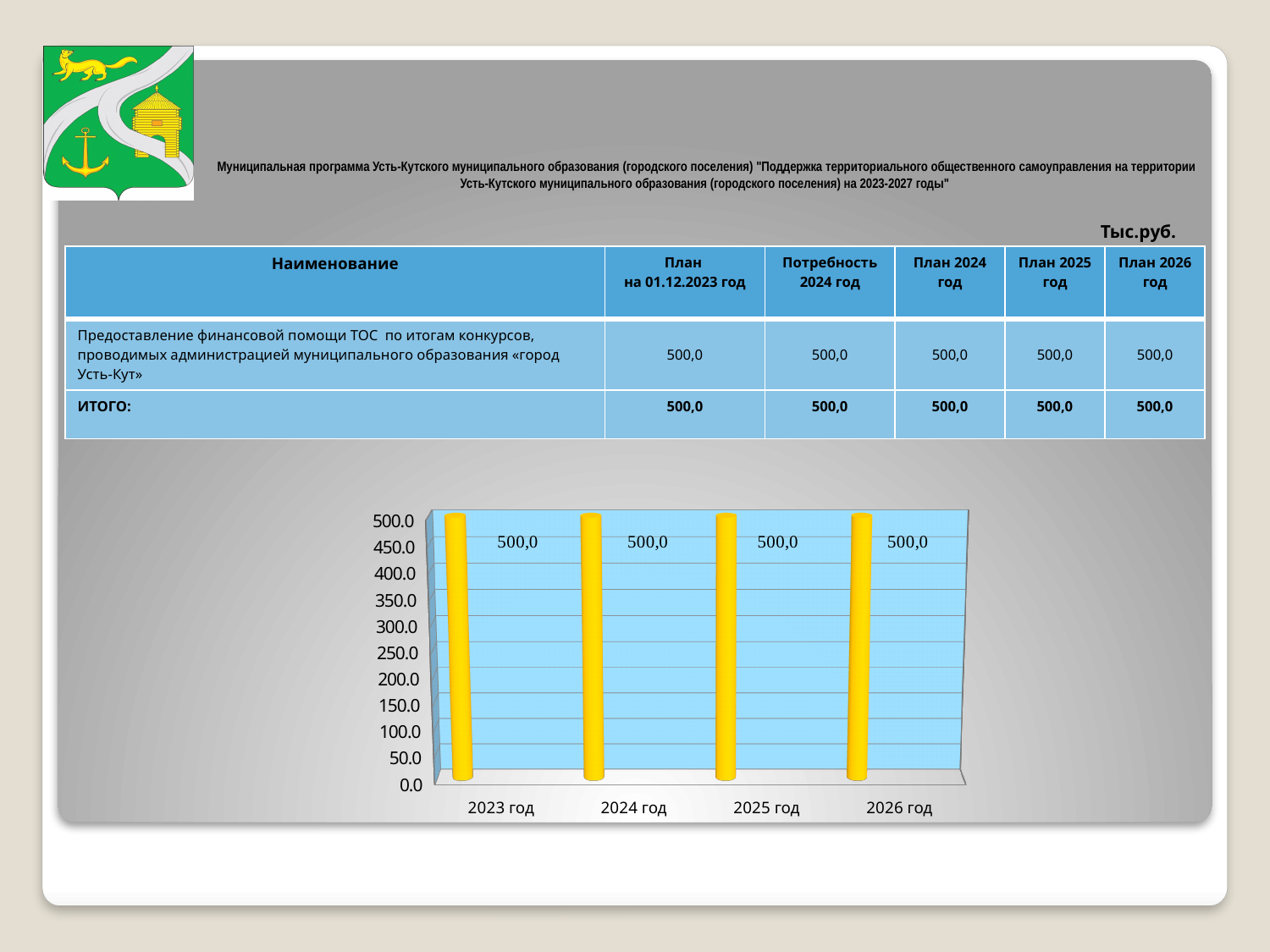
What is the highest tick value shown on the vertical axis of the chart? 500.0 What is the difference between the values for 2023 год and 2026 год? 0,0 What is the value for 2026 год in the chart? 500,0 What is the value for 2024 год in the chart? 500,0 Do the values rise, fall or stay the same from 2023 год to 2026 год? stay the same Is the value for 2024 год greater or less than 250.0? greater How many categories (years) are shown on the x axis of the chart? 4 What is the value for 2025 год in the chart? 500,0 What is the value for 2023 год in the chart? 500,0 What kind of chart is shown on the slide? bar chart What colour are the bars in the chart? yellow Is the value for 2025 год greater or less than 400.0? greater